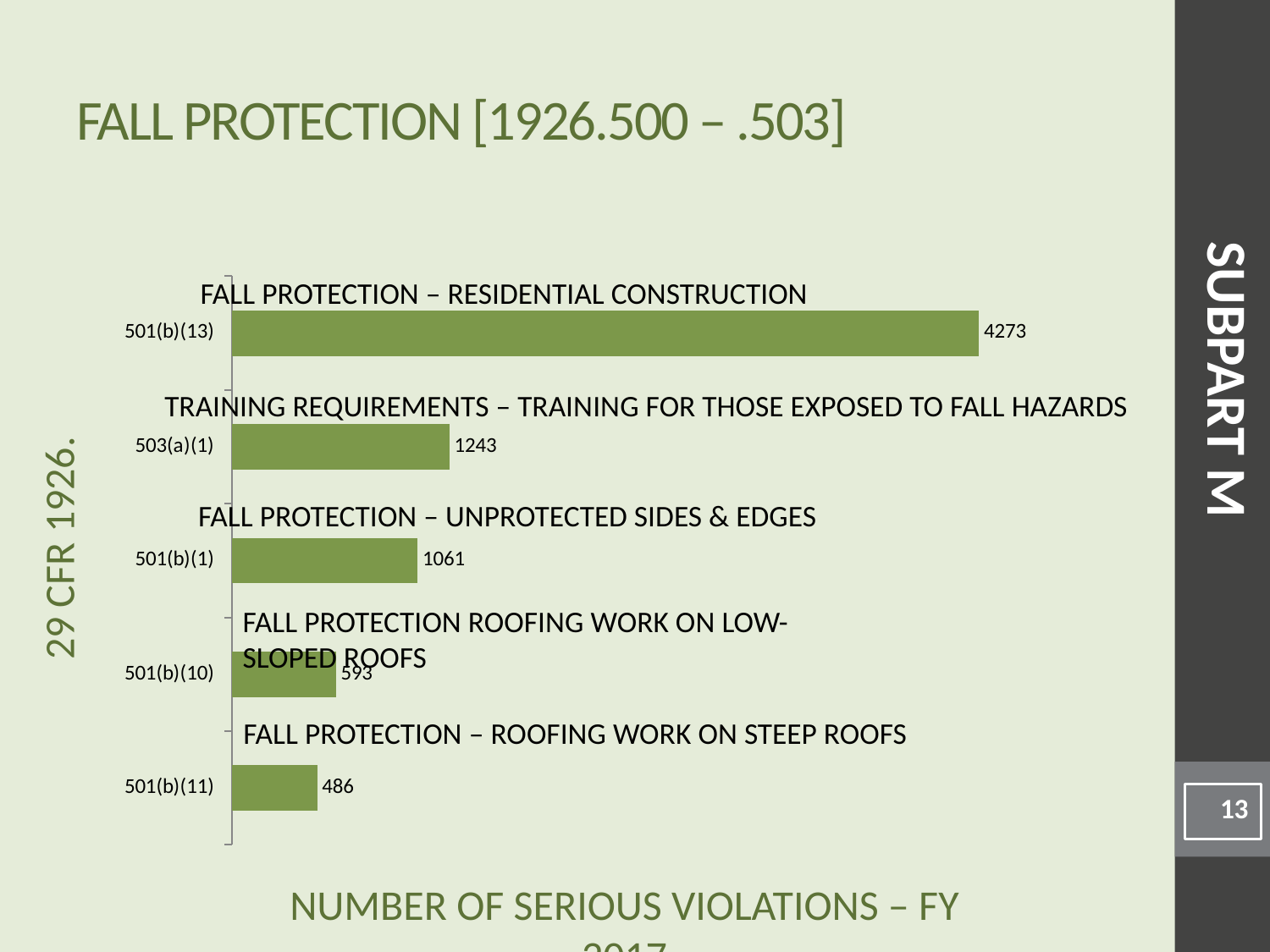
What is the difference in serious violations between 501(b)(10) and 501(b)(11)? 107 Which standard is described as 'FALL PROTECTION – UNPROTECTED SIDES & EDGES'? 501(b)(1) Which standard has the lowest number of serious violations? 501(b)(11) Which standard has the highest number of serious violations? 501(b)(13) Which has more serious violations, 503(a)(1) or 501(b)(1)? 503(a)(1) How many standards (bars) are shown in the chart? 5 What is the number of serious violations for 501(b)(1)? 1061 What is the number of serious violations for 501(b)(11)? 486 What is the number of serious violations for 503(a)(1)? 1243 What type of chart is shown on the slide? Bar chart What is the number of serious violations for 501(b)(13)? 4273 What is the difference in serious violations between 501(b)(13) and 503(a)(1)? 3030